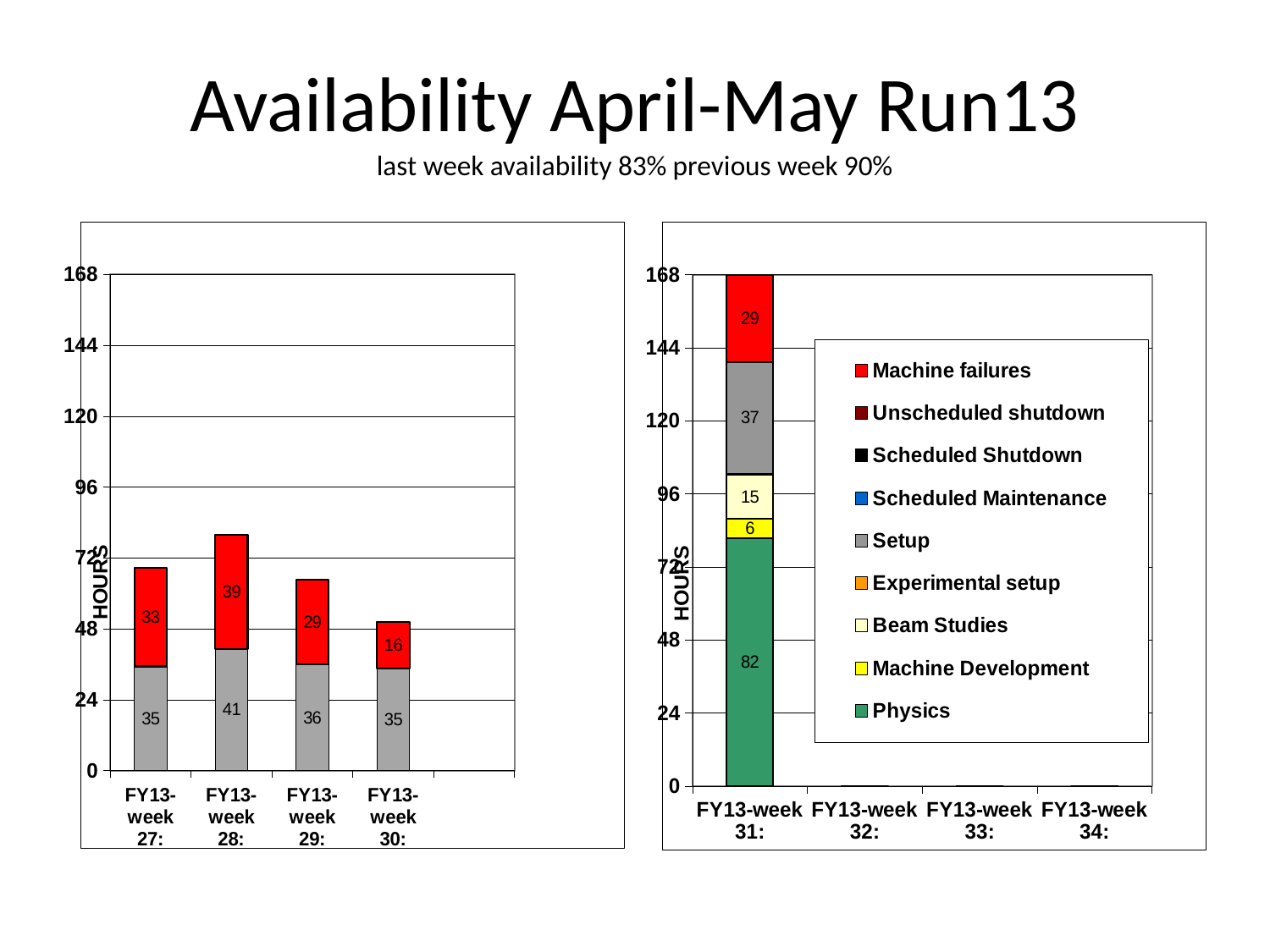
In the left chart, is the total bar for FY13-week 30 greater or less than 72? less In the left chart, what is the value of the gray segment for FY13-week 29? 36 In the left chart, which week has the largest red segment? FY13-week 28 In the right chart, for FY13-week 31, which is larger: Beam Studies or Machine Development? Beam Studies In the right chart, what is the Physics value for FY13-week 31? 82 In the right chart, how many series does the legend list? 9 In the left chart, what is the total height of the stacked bar for FY13-week 28? 80 In the left chart, which week has the smallest red segment? FY13-week 30 In the left chart, what is the value of the red segment for FY13-week 28? 39 In the left chart, what is the difference between the red segment values for FY13-week 27 and FY13-week 30? 17 In the right chart, what is the Setup value for FY13-week 31? 37 In the left chart, how many weeks are shown on the x axis? 4